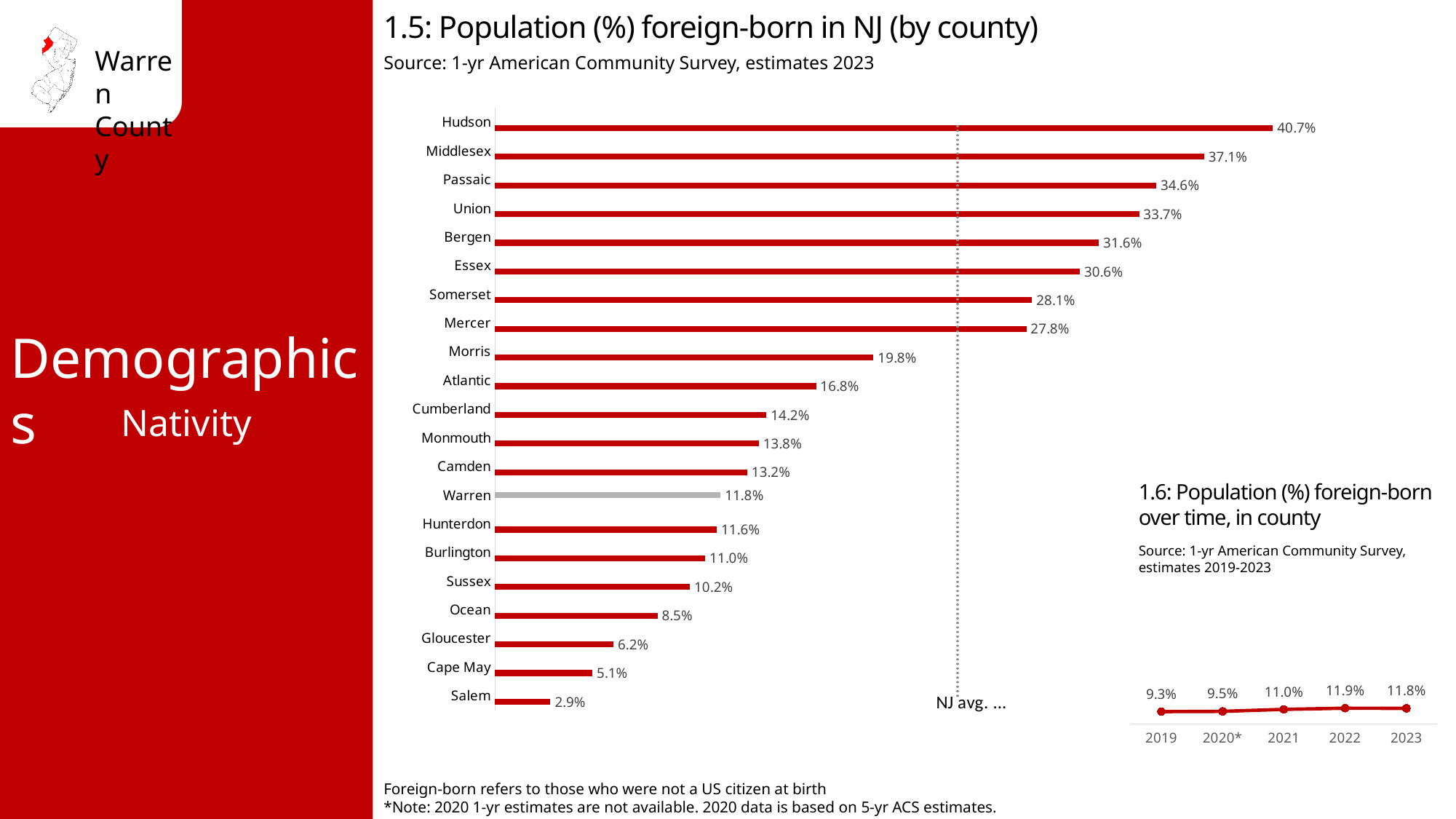
In chart 1.6 (Population (%) foreign-born over time, in county), what is the value for 2021? 11.0% In chart 1.6 (Population (%) foreign-born over time, in county), what is the difference between 2023 and 2019? 2.5% In chart 1.5 (Population (%) foreign-born in NJ by county), which county has the lowest value? Salem In chart 1.6 (Population (%) foreign-born over time, in county), which year has the highest value? 2022 In chart 1.5 (Population (%) foreign-born in NJ by county), which bar is shown in grey rather than red? Warren In chart 1.5 (Population (%) foreign-born in NJ by county), what is the value for Warren? 11.8% In chart 1.5 (Population (%) foreign-born in NJ by county), what is the value for Middlesex? 37.1% What kind of chart is chart 1.5 (Population (%) foreign-born in NJ by county)? Bar chart In chart 1.5 (Population (%) foreign-born in NJ by county), which county has the highest value? Hudson In chart 1.5 (Population (%) foreign-born in NJ by county), how many counties are shown? 21 In chart 1.5 (Population (%) foreign-born in NJ by county), which is larger, Morris or Atlantic? Morris In chart 1.5 (Population (%) foreign-born in NJ by county), what is the difference between Hudson and Salem? 37.8%